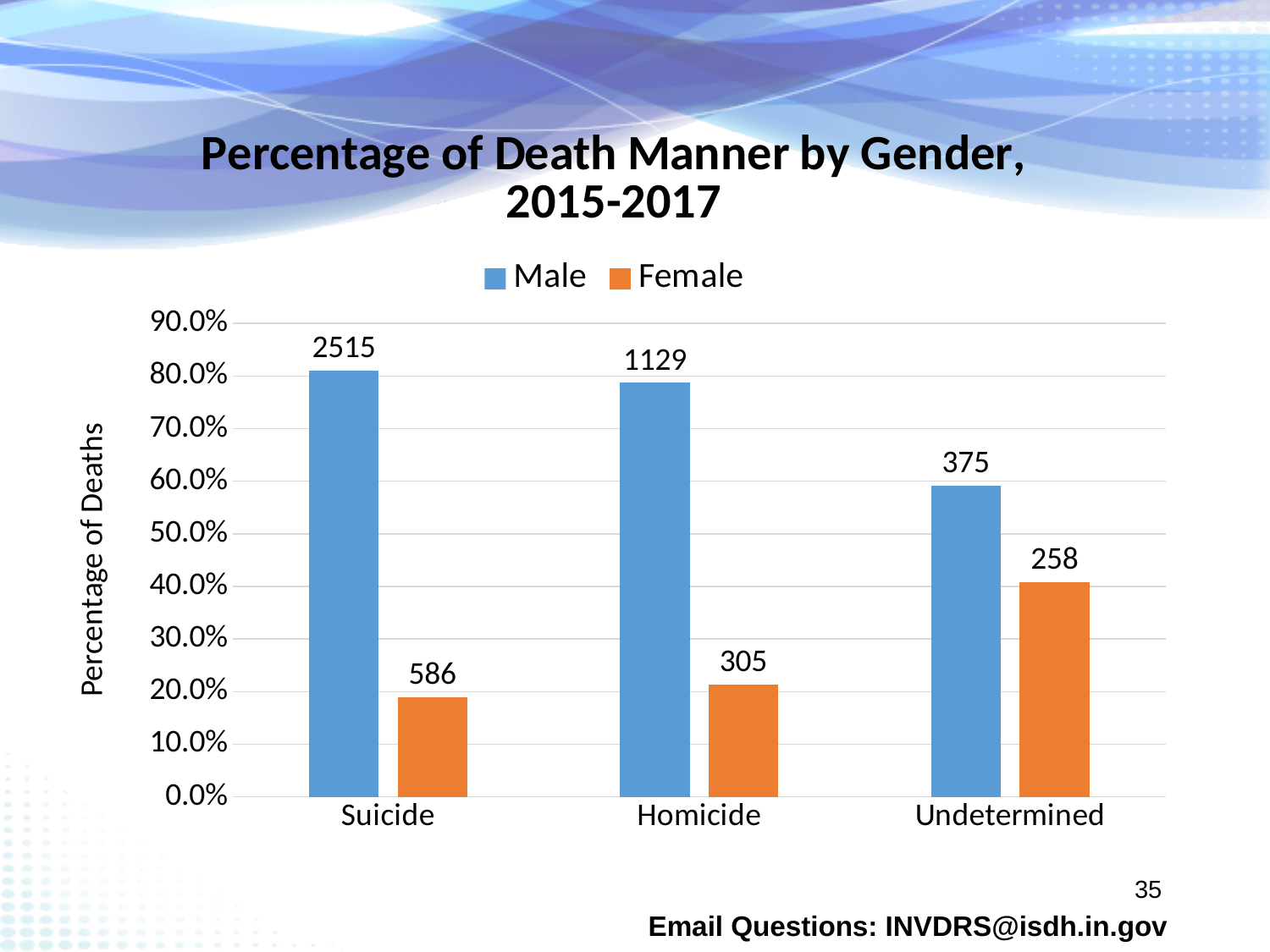
What is the data label on the Male bar for Suicide? 2515 What is the data label on the Male bar for Undetermined? 375 What is the data label on the Female bar for Homicide? 305 For Homicide, which is larger, the Male bar or the Female bar? Male Which death manner category has the tallest Female bar? Undetermined What is the data label on the Female bar for Undetermined? 258 What is the data label on the Male bar for Homicide? 1129 What is the data label on the Female bar for Suicide? 586 How many series does the legend list? 2 What is the label on the vertical axis? Percentage of Deaths Is the Female bar for Suicide greater or less than 30.0%? less Is the Male bar for Undetermined greater or less than 50.0%? greater